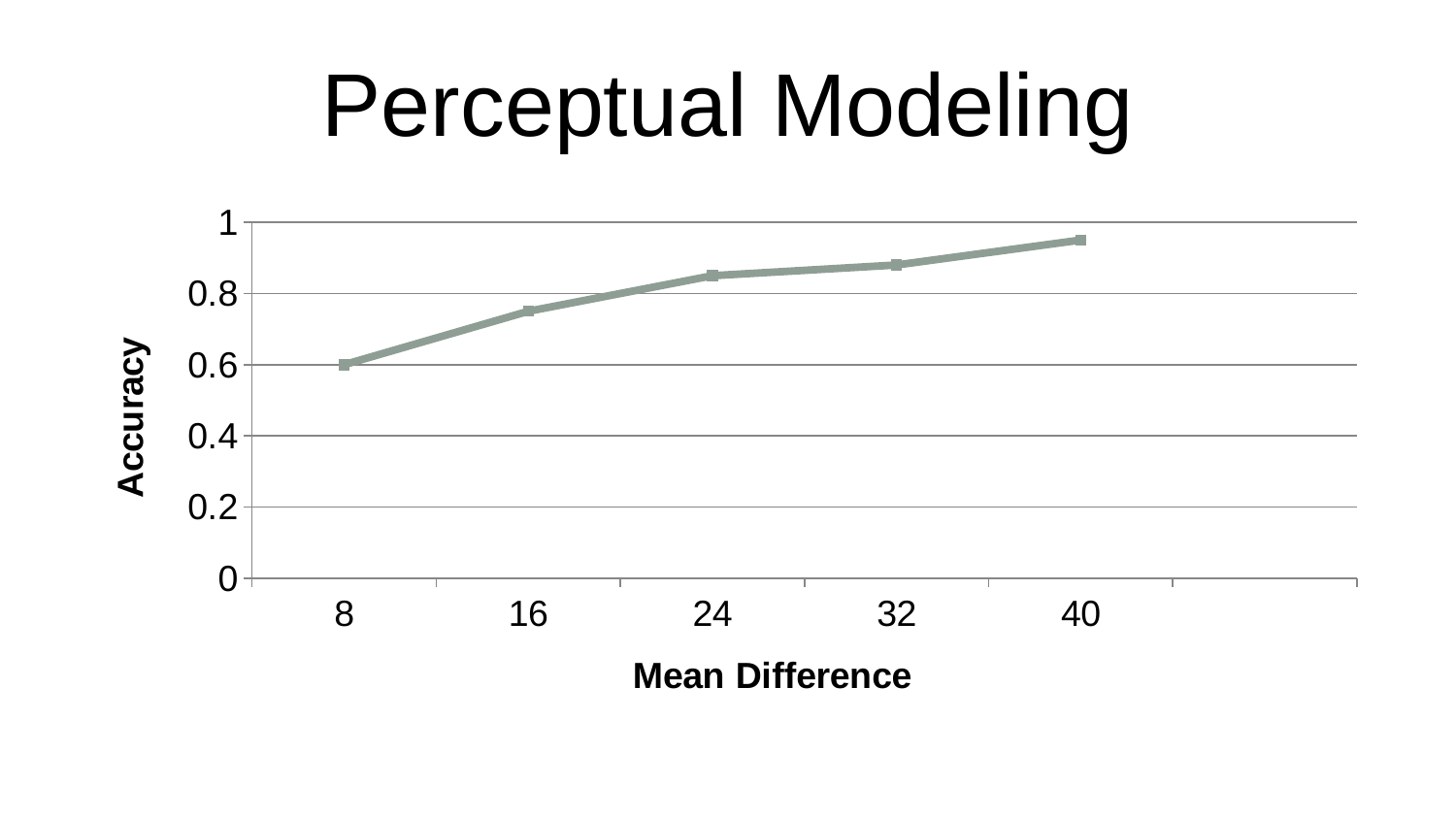
Is the Accuracy at a Mean Difference of 24 greater or less than 0.8? greater Is the Accuracy at a Mean Difference of 16 greater or less than 0.8? less Does Accuracy rise or fall as Mean Difference increases along the x axis? rise What kind of chart is shown on the slide? line chart At which Mean Difference is Accuracy lowest? 8 Which has the higher Accuracy, a Mean Difference of 8 or 40? 40 What is the label of the y axis? Accuracy What is the Accuracy at a Mean Difference of 8? 0.6 How many data points are plotted on the line? 5 At which Mean Difference is Accuracy highest? 40 What is the label of the x axis? Mean Difference Is the Accuracy at a Mean Difference of 40 greater or less than 0.8? greater